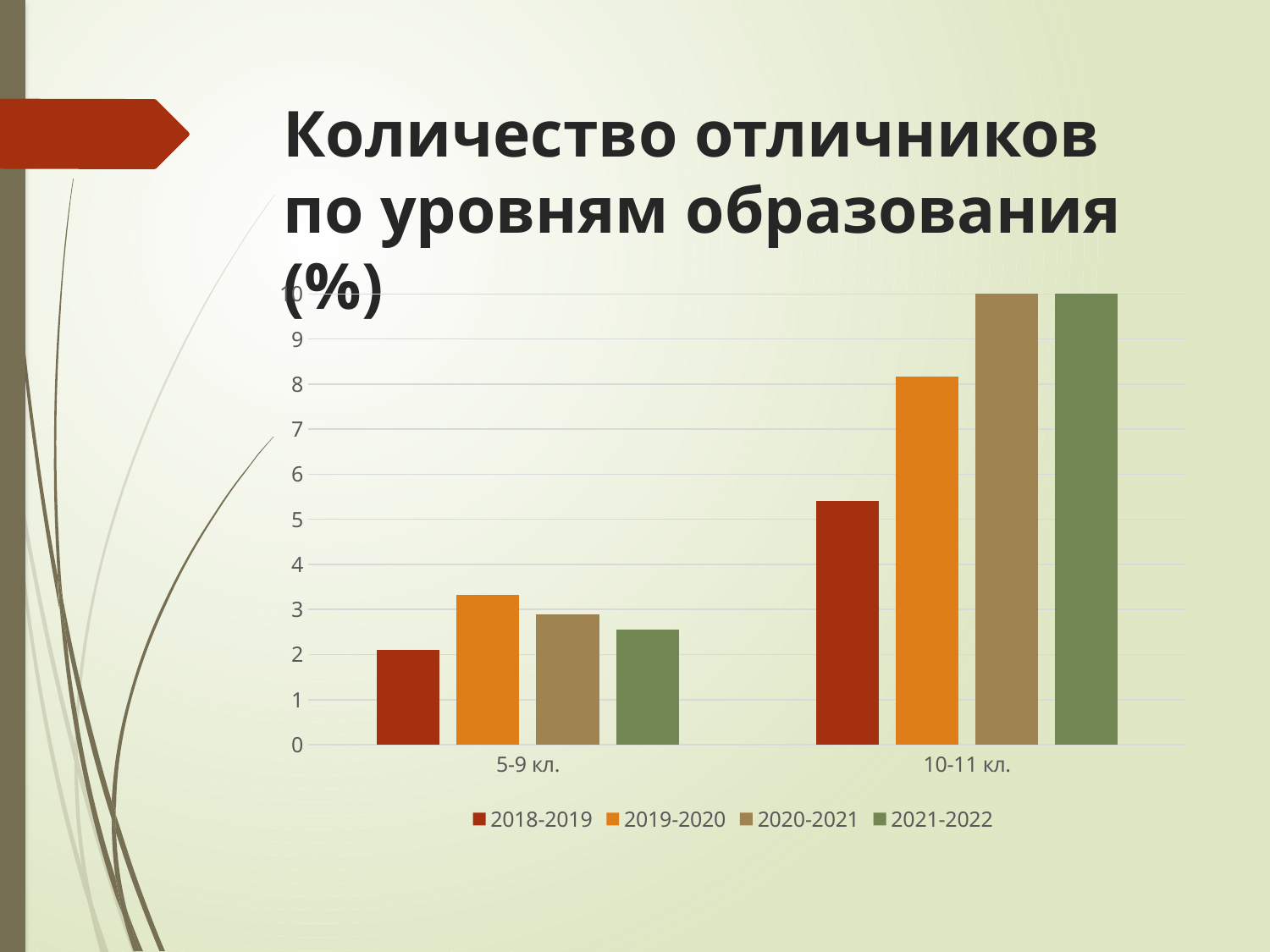
Is the value for 2018-2019 in 10-11 кл. greater or less than 5? greater Is the value for 2018-2019 in 5-9 кл. greater or less than 3? less Which series has the lowest value for 5-9 кл.? 2018-2019 For the 2018-2019 series, which category has the larger value, 5-9 кл. or 10-11 кл.? 10-11 кл. Which series has the highest value for 5-9 кл.? 2019-2020 Is the value for 2019-2020 in 10-11 кл. greater or less than 9? less How many categories are shown on the x axis? 2 What kind of chart is shown on the slide? bar chart How many series does the legend list? 4 Which series has the lowest value for 10-11 кл.? 2018-2019 What is the title of the chart? Количество отличников по уровням образования (%)